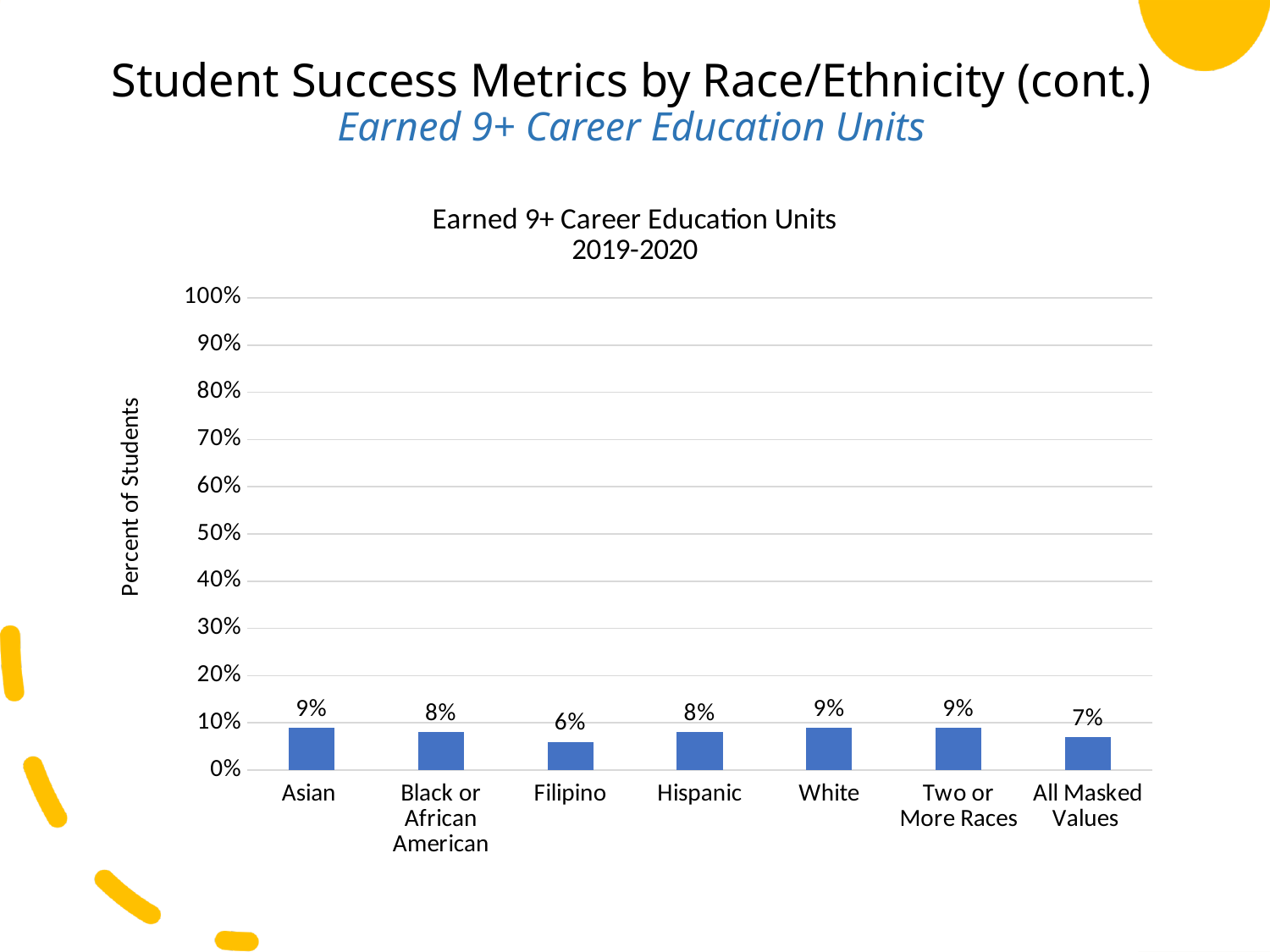
What is the difference between the values for Black or African American and All Masked Values? 1% Which category has the lowest value? Filipino What is the label of the vertical axis? Percent of Students What kind of chart is shown on the slide? bar chart Is the value for White students greater or less than 20%? less How many race/ethnicity categories are shown on the chart? 7 Which is larger, the value for Two or More Races or the value for All Masked Values? Two or More Races What is the value for Filipino students? 6% What is the value for Hispanic students? 8% What percentage of Asian students earned 9+ Career Education Units? 9% What is the difference between the values for White and Filipino students? 3% What is the value for All Masked Values? 7%